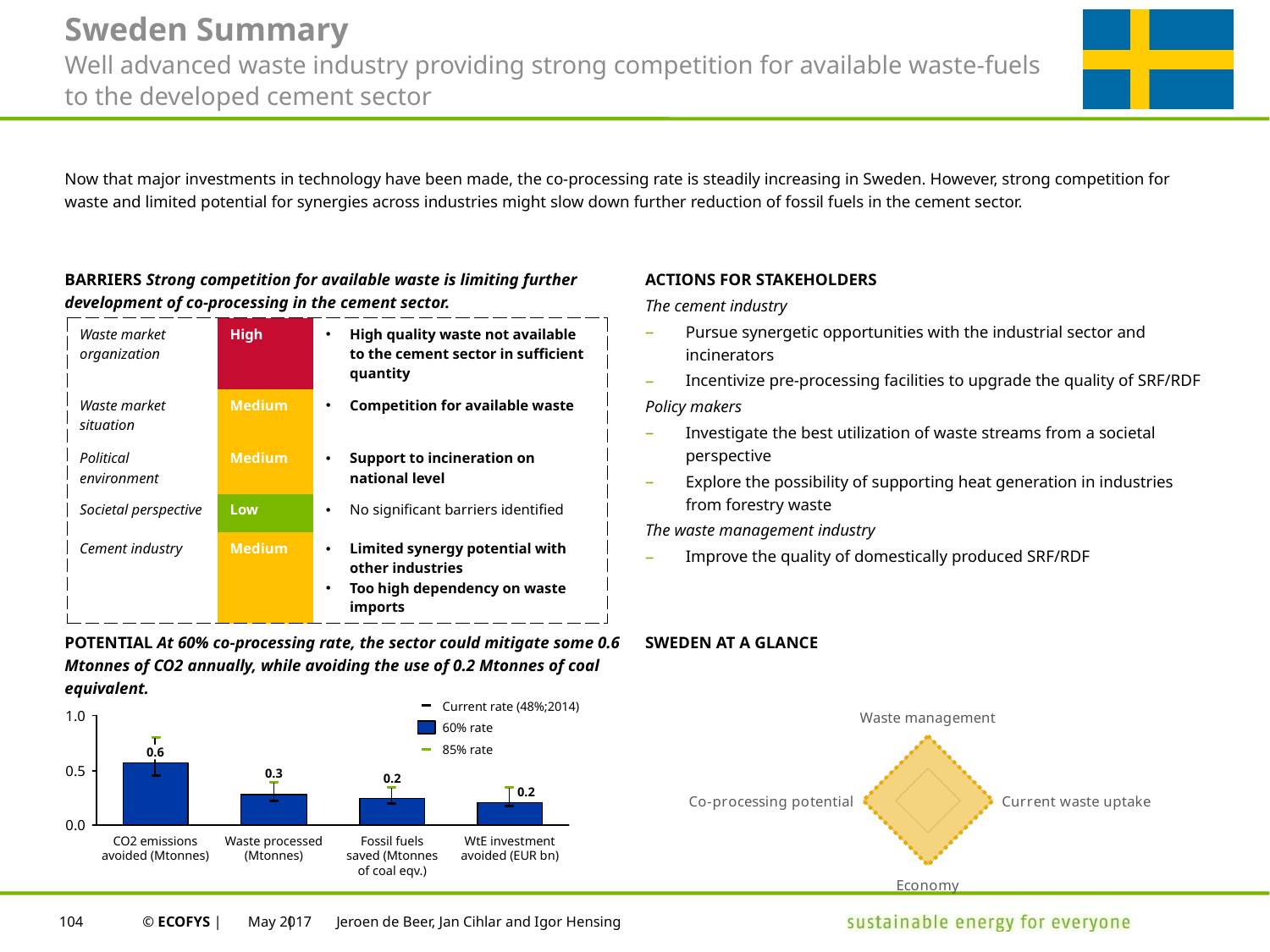
In the bar chart under POTENTIAL, which is larger: the labelled value for Waste processed or for Fossil fuels saved? Waste processed In the bar chart under POTENTIAL, what is the labelled value for CO2 emissions avoided (Mtonnes) at the 60% rate? 0.6 In the bar chart under POTENTIAL, how many entries does the legend list? 3 In the bar chart under POTENTIAL, is the bar for CO2 emissions avoided greater or less than 0.5? greater In the bar chart under POTENTIAL, what is the labelled value for Fossil fuels saved (Mtonnes of coal eqv.)? 0.2 In the bar chart under POTENTIAL, what is the labelled value for Waste processed (Mtonnes)? 0.3 In the bar chart under POTENTIAL, what is the difference between the labelled values for CO2 emissions avoided and Waste processed? 0.3 In the bar chart under POTENTIAL, how many categories are shown on the x axis? 4 In the bar chart under POTENTIAL, which category has the highest labelled value? CO2 emissions avoided (Mtonnes) In the bar chart under POTENTIAL, what is the first legend entry? Current rate (48%;2014) What kind of chart is shown under the POTENTIAL heading? Bar chart In the bar chart under POTENTIAL, what is the labelled value for WtE investment avoided (EUR bn)? 0.2